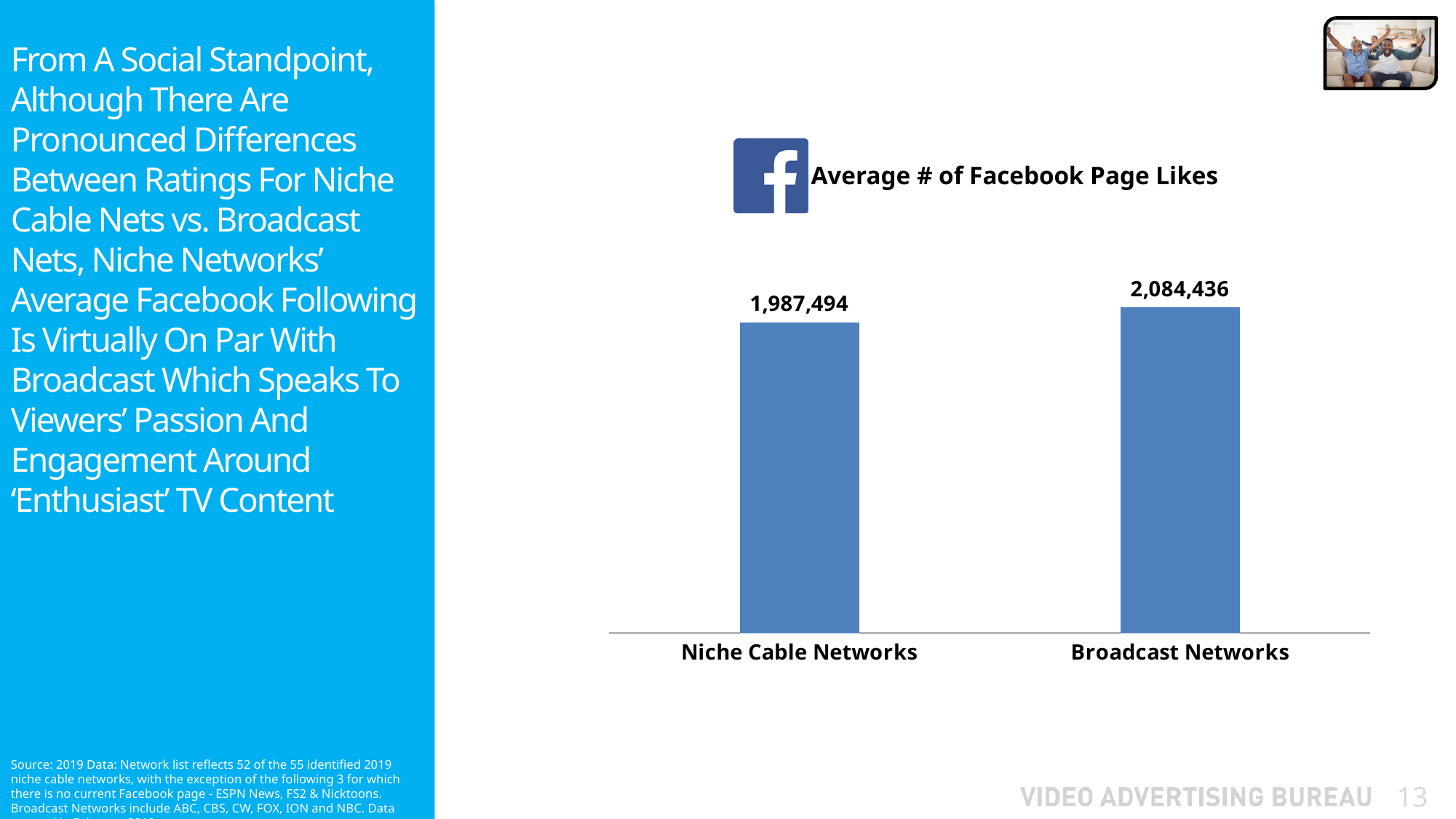
What is the average number of Facebook page likes for Niche Cable Networks? 1,987,494 Which category has the lower average number of Facebook page likes? Niche Cable Networks What is the title of the chart? Average # of Facebook Page Likes How many categories are shown in the chart? 2 What kind of chart is shown on the slide? bar chart Which category has the higher average number of Facebook page likes? Broadcast Networks What is the average number of Facebook page likes for Broadcast Networks? 2,084,436 What is the difference in average Facebook page likes between Broadcast Networks and Niche Cable Networks? 96,942 Is the value for Broadcast Networks larger or smaller than the value for Niche Cable Networks? larger What colour are the bars in the chart? blue